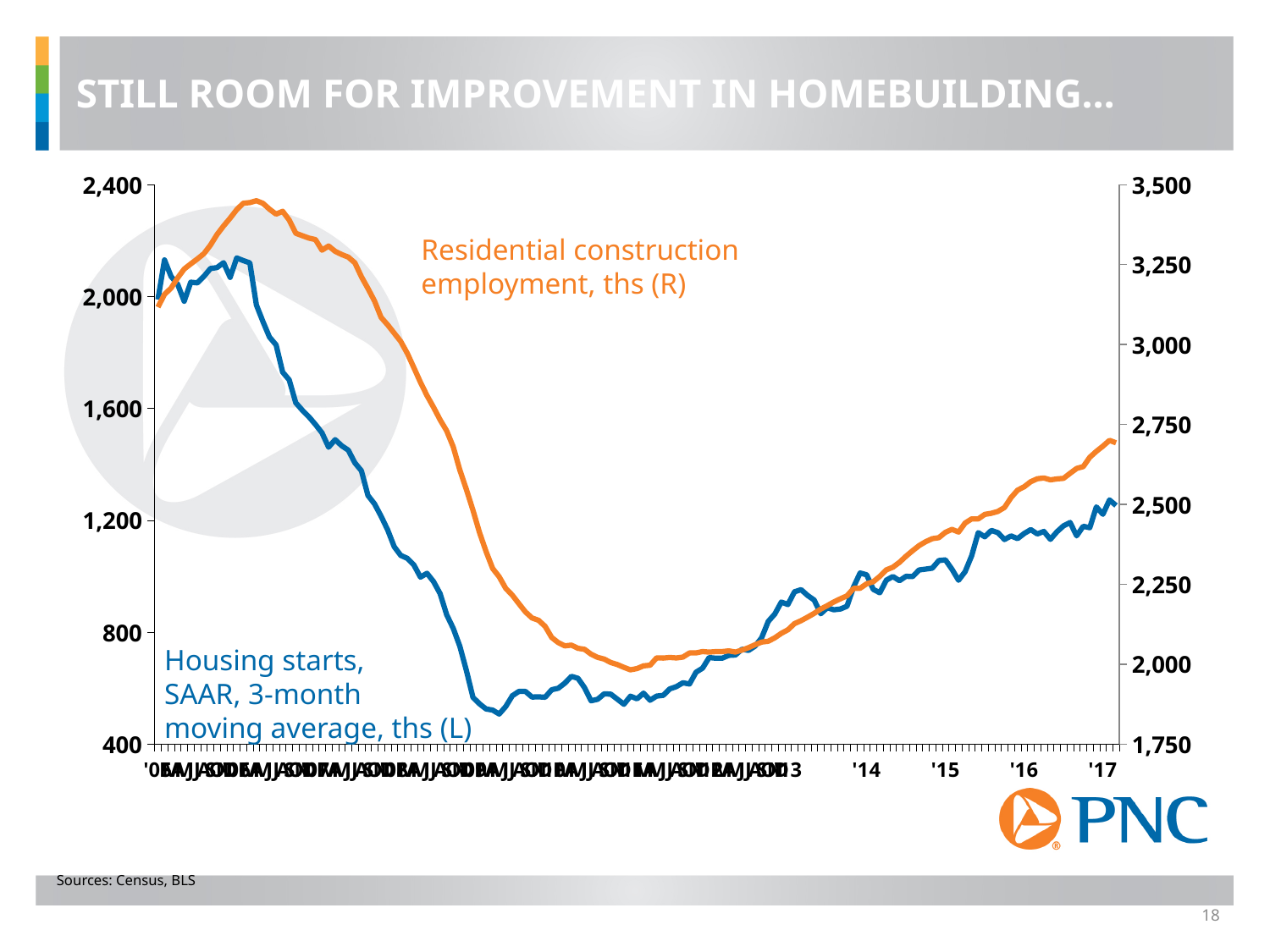
Which axis, left or right, is used for the Residential construction employment series? right Is the value of Housing starts at '14 greater or less than 1,200? less How many data series are plotted on the chart? 2 Is the value of Residential construction employment at '17 greater or less than 2,750? less What is the title of the slide? STILL ROOM FOR IMPROVEMENT IN HOMEBUILDING... Does the Residential construction employment series rise or fall between '14 and '17? rise Is the highest value of the Housing starts series greater or less than 2,000? greater What kind of chart is shown on the slide? line chart